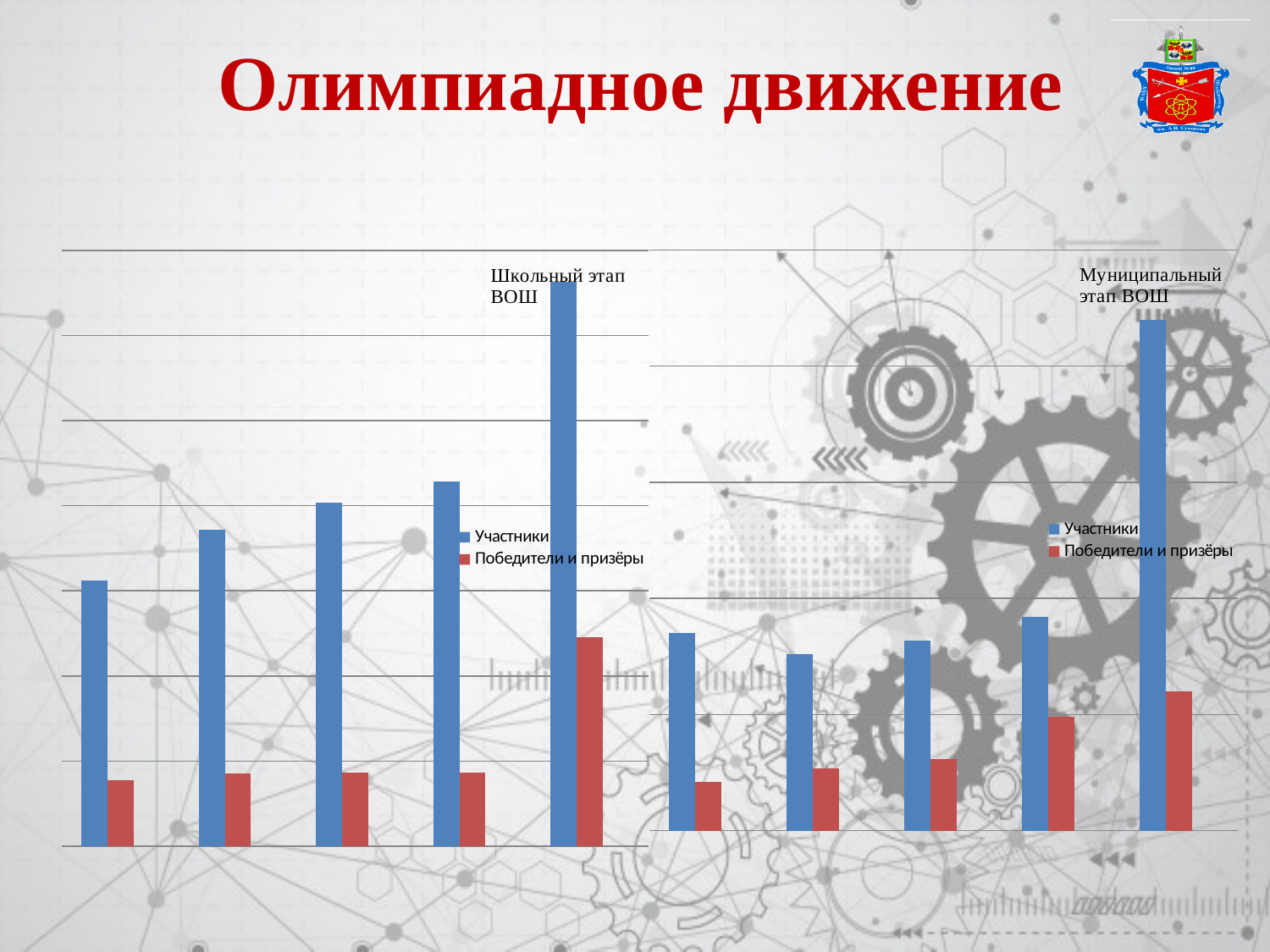
How many groups of bars are plotted in the "Муниципальный этап ВОШ" chart? 5 Which series is shown in red in the "Муниципальный этап ВОШ" chart? Победители и призёры How many series does the legend of the "Муниципальный этап ВОШ" chart list? 2 What kind of chart is the "Муниципальный этап ВОШ" chart on the right? bar chart In the "Школьный этап ВОШ" chart, which group of bars has the highest value for Участники? the rightmost (fifth) group In the "Муниципальный этап ВОШ" chart, which group of bars has the lowest value for Победители и призёры? the leftmost (first) group What kind of chart is the "Школьный этап ВОШ" chart on the left? bar chart In the "Школьный этап ВОШ" chart, do the values for Участники rise or fall from left to right? rise In the "Муниципальный этап ВОШ" chart, do the values for Победители и призёры rise or fall from left to right? rise How many groups of bars are plotted in the "Школьный этап ВОШ" chart? 5 How many series does the legend of the "Школьный этап ВОШ" chart list? 2 In the rightmost group of the "Школьный этап ВОШ" chart, which is larger: Участники or Победители и призёры? Участники